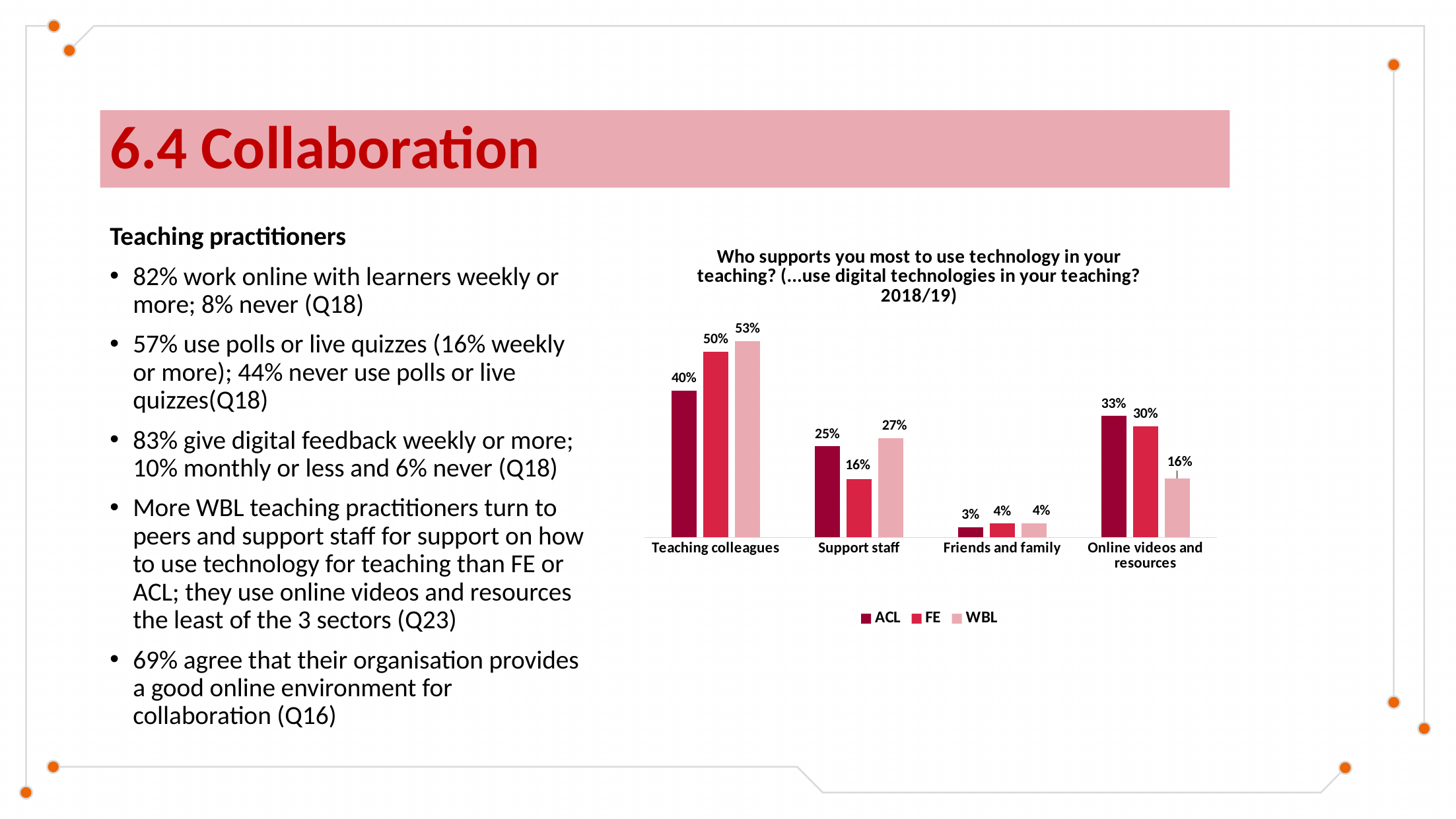
Which is larger for Support staff: the ACL value or the FE value? ACL What is the value for FE in the Support staff category? 16% How many series does the legend list? 3 How many categories are shown on the x axis? 4 Which category has the highest value for the ACL series? Teaching colleagues What is the difference between the WBL and ACL values for Teaching colleagues? 13% What is the value for WBL in the Teaching colleagues category? 53% Which category has the lowest value for the WBL series? Friends and family Which series is shown in the lightest pink colour in the legend? WBL What kind of chart is shown on the slide? Bar chart What is the difference between the ACL and WBL values for Online videos and resources? 17% What is the value for ACL in the Online videos and resources category? 33%